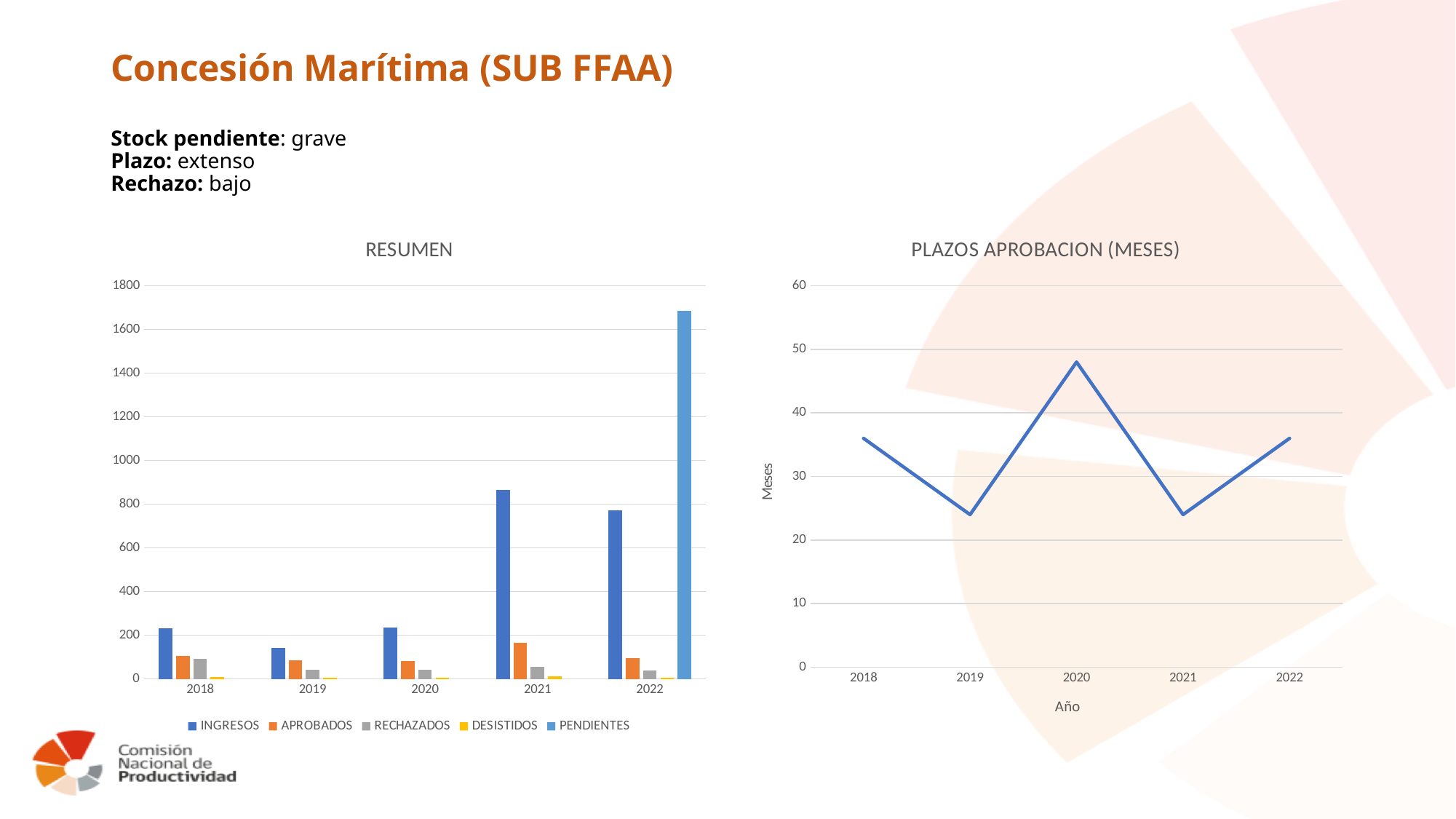
In the RESUMEN chart, is the PENDIENTES value for 2022 greater or less than 1600? greater What kind of chart is the PLAZOS APROBACION (MESES) chart? line chart How many years are shown on the x axis of the RESUMEN chart? 5 In the RESUMEN chart, which is larger: INGRESOS in 2021 or INGRESOS in 2022? INGRESOS in 2021 In the RESUMEN chart, which year has the highest INGRESOS value? 2021 In the PLAZOS APROBACION (MESES) chart, is the value for 2019 greater or less than 30? less In the RESUMEN chart, is the INGRESOS value for 2021 greater or less than 800? greater How many series does the legend of the RESUMEN chart list? 5 What kind of chart is the RESUMEN chart? bar chart In the RESUMEN chart, which year has the lowest INGRESOS value? 2019 In the PLAZOS APROBACION (MESES) chart, which year has the highest value? 2020